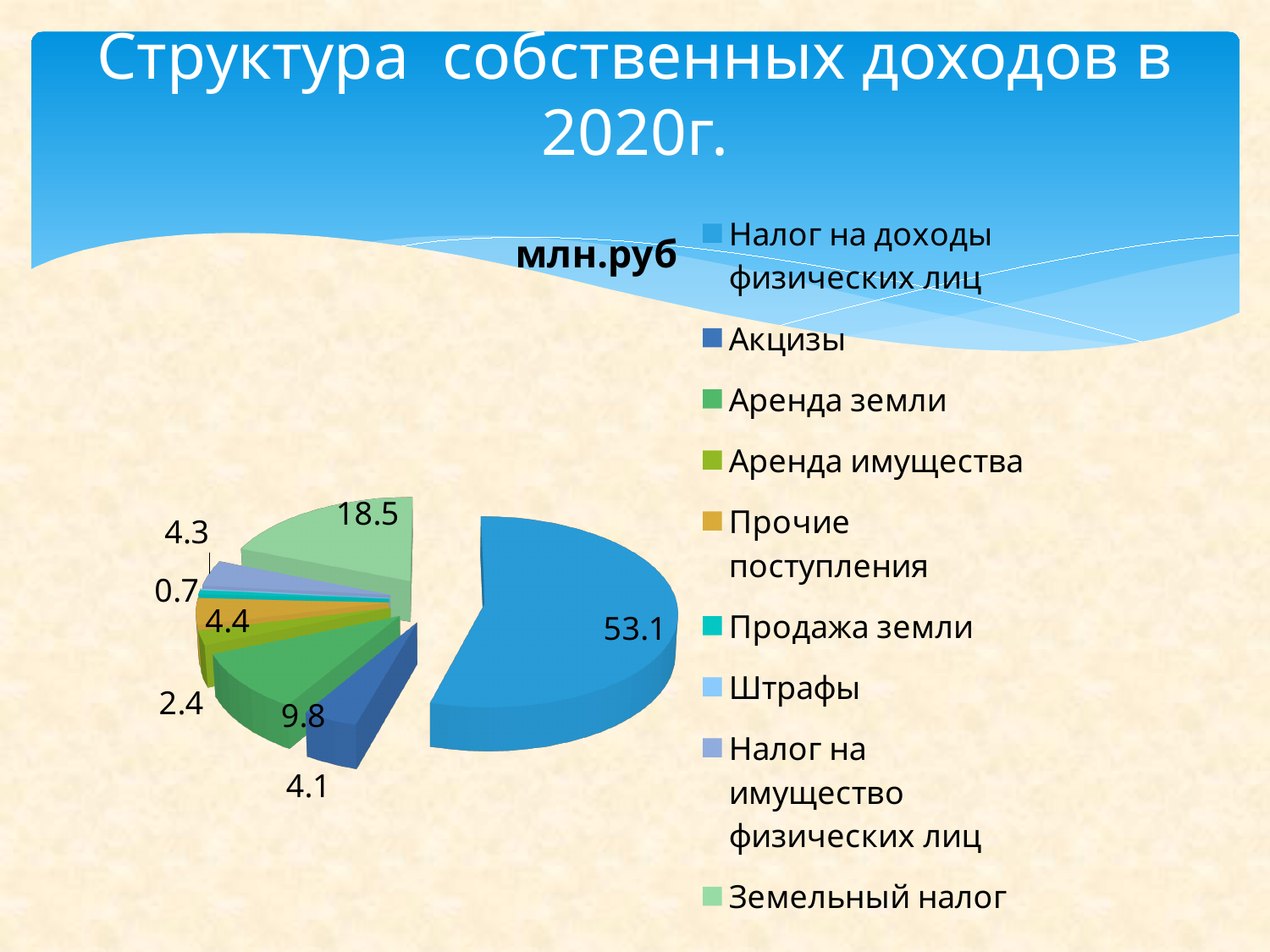
What is the value for Акцизы? 4.1 How many categories does the legend list? 9 Which is larger, the value for Аренда земли or the value for Акцизы? Аренда земли What is the value for Налог на доходы физических лиц? 53.1 What is the value for Прочие поступления? 4.4 What is the value for Земельный налог? 18.5 What is the difference between the values for Налог на доходы физических лиц and Земельный налог? 34.6 What is the value for Аренда земли? 9.8 Which category has the largest slice of the pie? Налог на доходы физических лиц What unit label is shown above the legend? млн.руб What kind of chart is shown on the slide? pie chart What is the value for Аренда имущества? 2.4